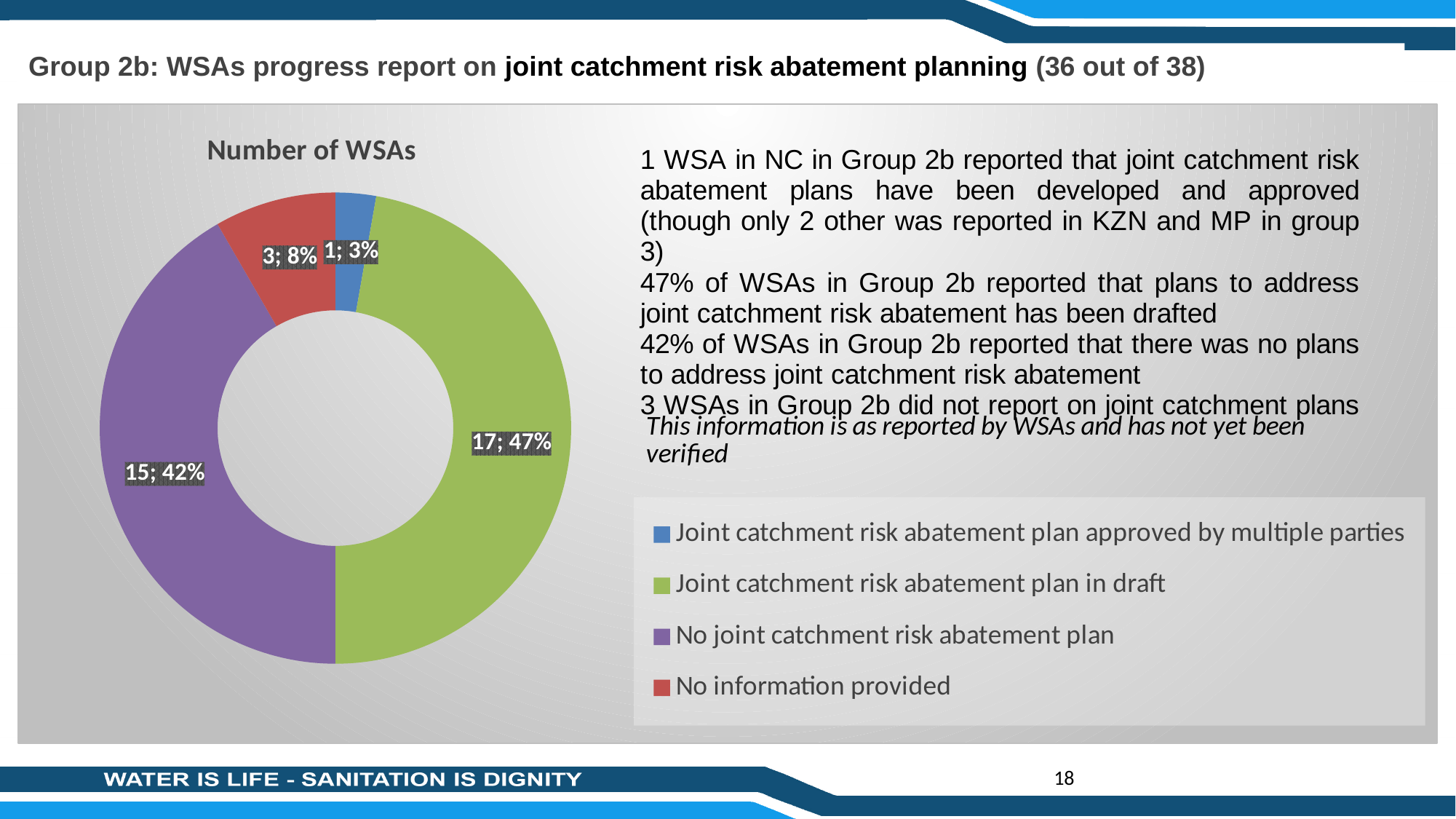
Which is larger: the number of WSAs with no information provided or the number with a plan approved by multiple parties? No information provided What share of WSAs reported a joint catchment risk abatement plan approved by multiple parties? 3% Which category has the smallest slice of the chart? Joint catchment risk abatement plan approved by multiple parties Which category has the largest slice of the chart? Joint catchment risk abatement plan in draft How many WSAs provided no information? 3 How many WSAs reported a joint catchment risk abatement plan in draft? 17 What kind of chart is shown on the slide? Doughnut (pie) chart How many categories does the legend list? 4 What colour represents 'No joint catchment risk abatement plan' in the chart? Purple What percentage of WSAs have no joint catchment risk abatement plan? 42% What is the difference in the number of WSAs between 'Joint catchment risk abatement plan in draft' and 'No joint catchment risk abatement plan'? 2 What is the title of the chart? Number of WSAs